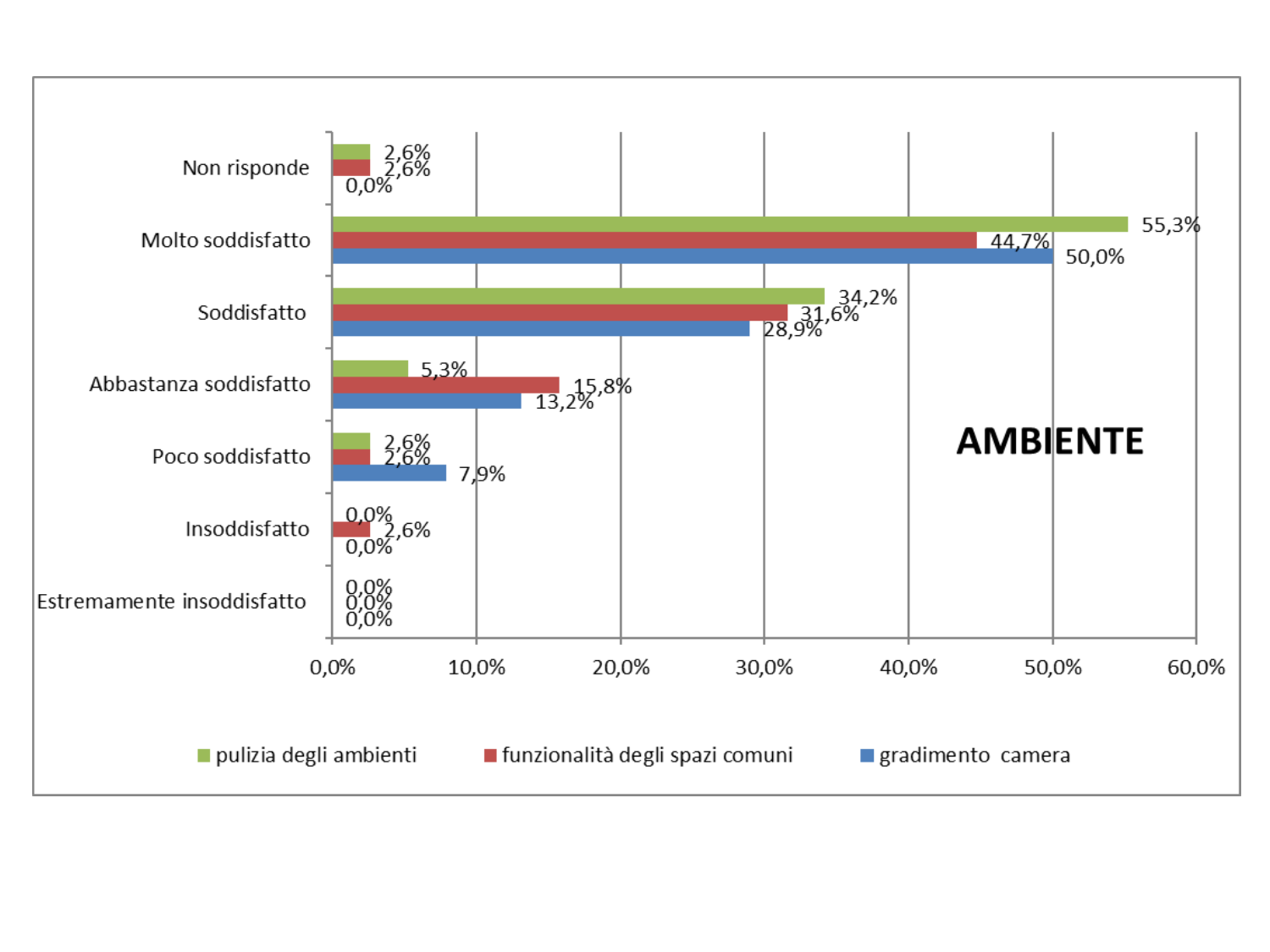
What is the value for 'pulizia degli ambienti' in the 'Molto soddisfatto' category? 55,3% How many categories are shown on the vertical axis? 7 What is the value for 'gradimento camera' in the 'Soddisfatto' category? 28,9% What is the difference between 'pulizia degli ambienti' and 'funzionalità degli spazi comuni' in the 'Molto soddisfatto' category? 10,6% Is the value for 'funzionalità degli spazi comuni' in the 'Molto soddisfatto' category greater or less than 40,0%? greater Which category has the highest value for 'gradimento camera'? Molto soddisfatto What is the value for 'funzionalità degli spazi comuni' in the 'Abbastanza soddisfatto' category? 15,8% Which is larger in the 'Abbastanza soddisfatto' category: 'pulizia degli ambienti' or 'gradimento camera'? gradimento camera How many series does the legend list? 3 What is the value for 'gradimento camera' in the 'Poco soddisfatto' category? 7,9% What label appears in large bold text inside the chart area? AMBIENTE What kind of chart is shown on the slide? bar chart